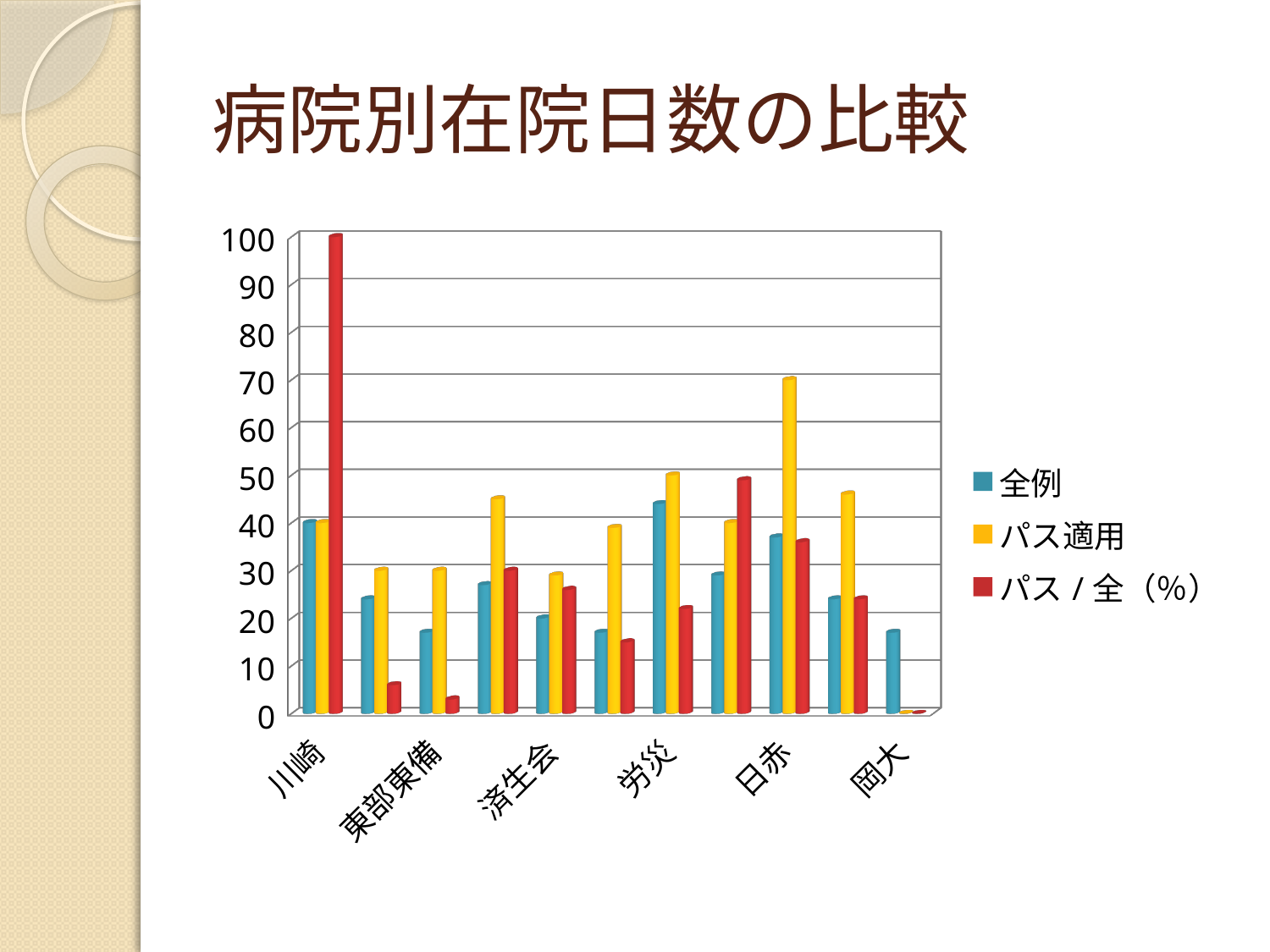
Which hospital has the highest パス / 全（%） value? 川崎 Is the value of パス / 全（%） for 東部東備 greater or less than 10? less How many series does the legend list? 3 For 日赤, which is larger: 全例 or パス適用? パス適用 What is the value of 全例 for 川崎? 40 What is the value of パス適用 for 日赤? 70 What are the three series named in the legend? 全例, パス適用, パス / 全（%） Is the value of 全例 for 岡大 greater or less than 20? less What is the title of the slide? 病院別在院日数の比較 What type of chart is shown on the slide? bar chart What is the value of パス / 全（%） for 川崎? 100 Which hospital has the highest パス適用 value? 日赤